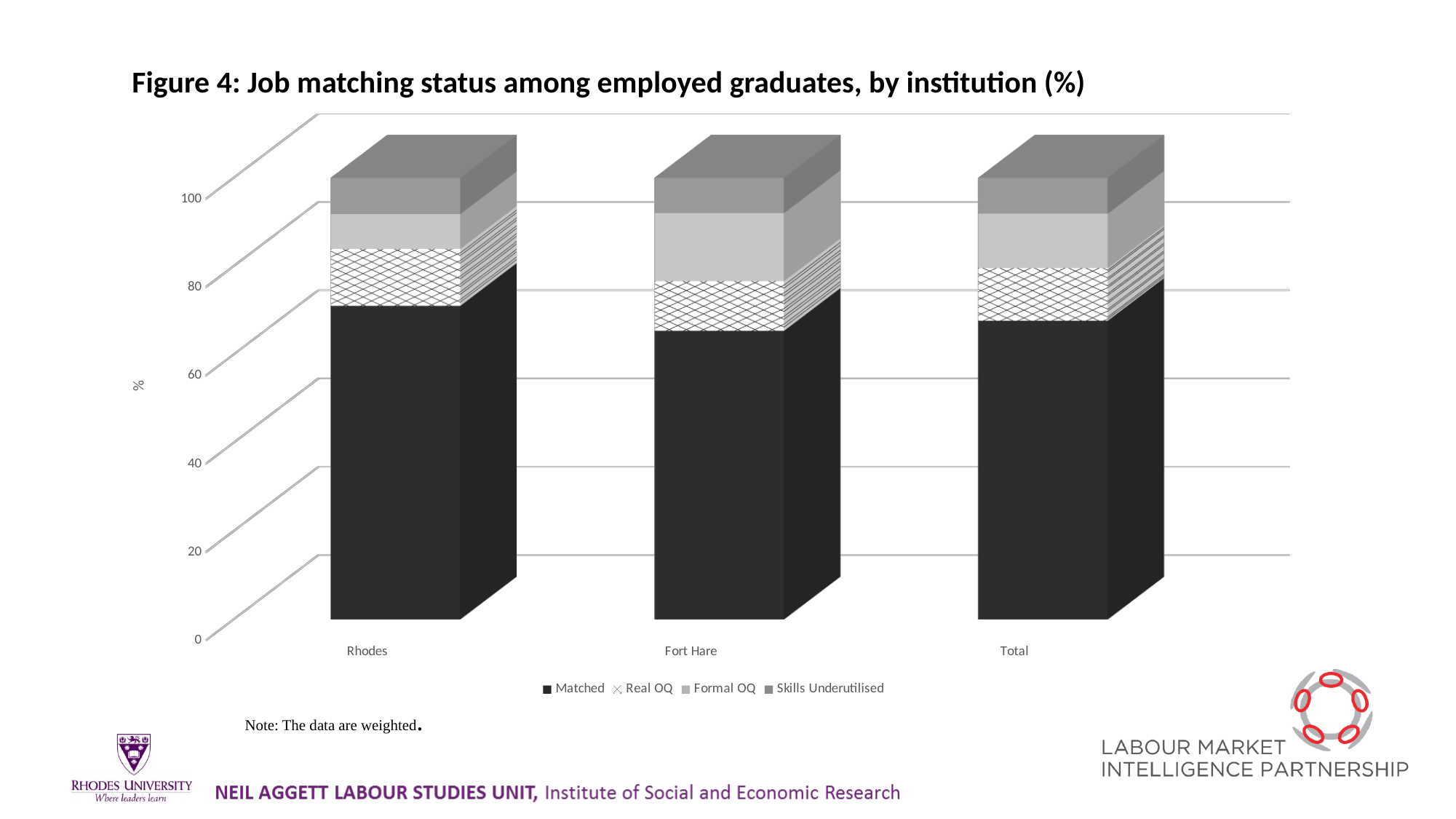
How many institutions (categories) are shown on the x axis? 3 Is the Matched value for Fort Hare greater or less than 80? less Is the Matched value for Rhodes greater or less than 60? greater Is the Matched value for Total greater or less than 60? greater Which has the larger Formal OQ segment, Rhodes or Fort Hare? Fort Hare Which institution has the highest Matched share? Rhodes Which has the larger Matched segment, Rhodes or Fort Hare? Rhodes What kind of chart is shown on the slide? Stacked bar chart Which institution has the lowest Matched share? Fort Hare What are the four series listed in the legend? Matched, Real OQ, Formal OQ, Skills Underutilised How many series does the legend list? 4 What is the title of the chart? Figure 4: Job matching status among employed graduates, by institution (%)